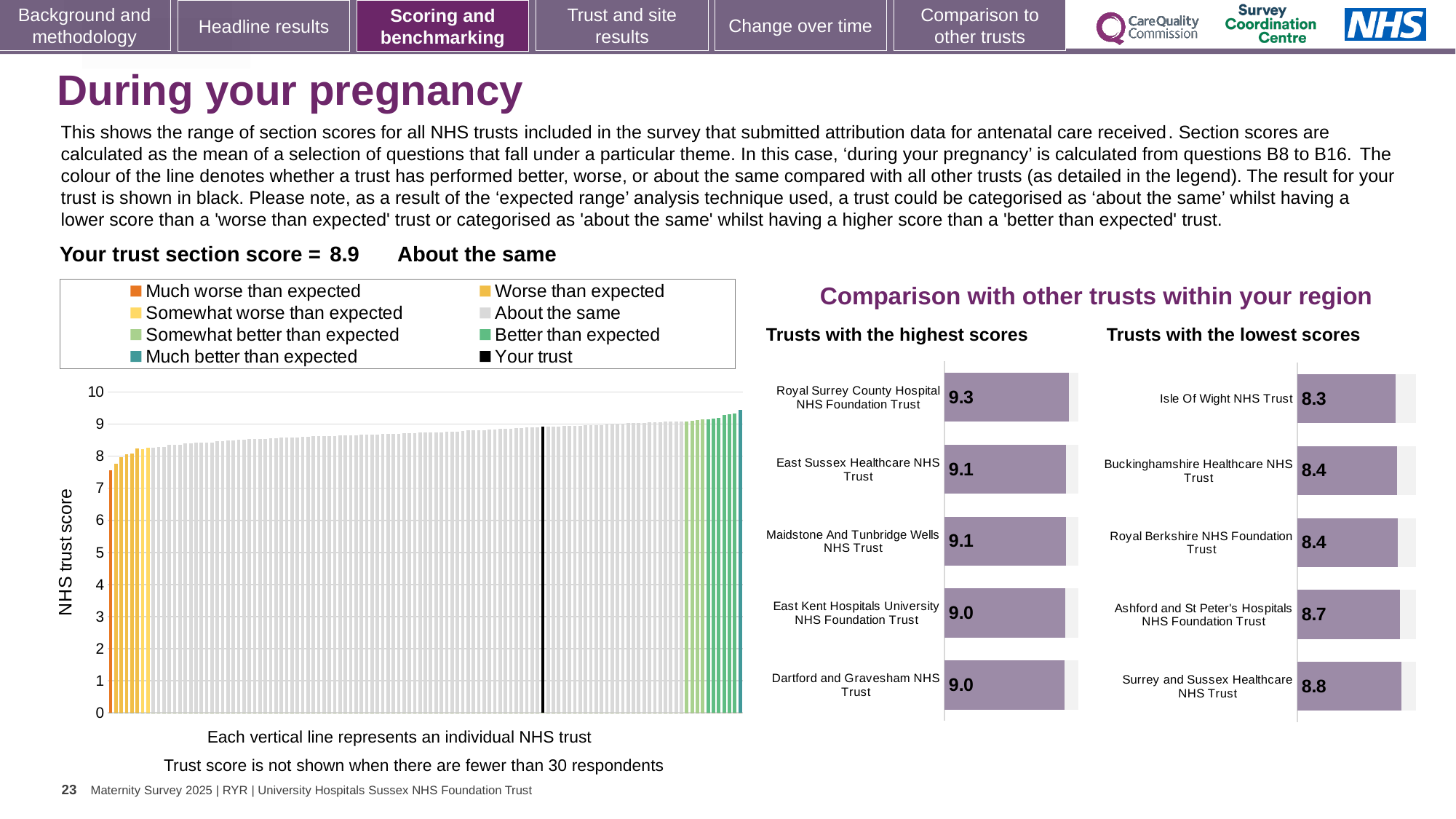
In the 'Trusts with the highest scores' chart, which trust has the highest score? Royal Surrey County Hospital NHS Foundation Trust In the main 'NHS trust score' chart on the left, do the bar values rise or fall from left to right? rise In the 'Trusts with the lowest scores' chart, which trust has the lowest score? Isle Of Wight NHS Trust What kind of chart is the 'Trusts with the lowest scores' chart? bar chart In the main 'NHS trust score' chart on the left, is the value of the leftmost (lowest) bar greater or less than 8? less In the 'Trusts with the lowest scores' chart, what is the score for Isle Of Wight NHS Trust? 8.3 How many entries does the legend of the main 'NHS trust score' chart list? 8 In the 'Trusts with the highest scores' chart, what is the score for Royal Surrey County Hospital NHS Foundation Trust? 9.3 In the 'Trusts with the highest scores' chart, how many trusts are shown? 5 In the 'Trusts with the lowest scores' chart, what is the score for Ashford and St Peter's Hospitals NHS Foundation Trust? 8.7 In the 'Trusts with the highest scores' chart, what is the difference between the scores of Royal Surrey County Hospital NHS Foundation Trust and Dartford and Gravesham NHS Trust? 0.3 In the 'Trusts with the lowest scores' chart, which has the larger score: Buckinghamshire Healthcare NHS Trust or Surrey and Sussex Healthcare NHS Trust? Surrey and Sussex Healthcare NHS Trust